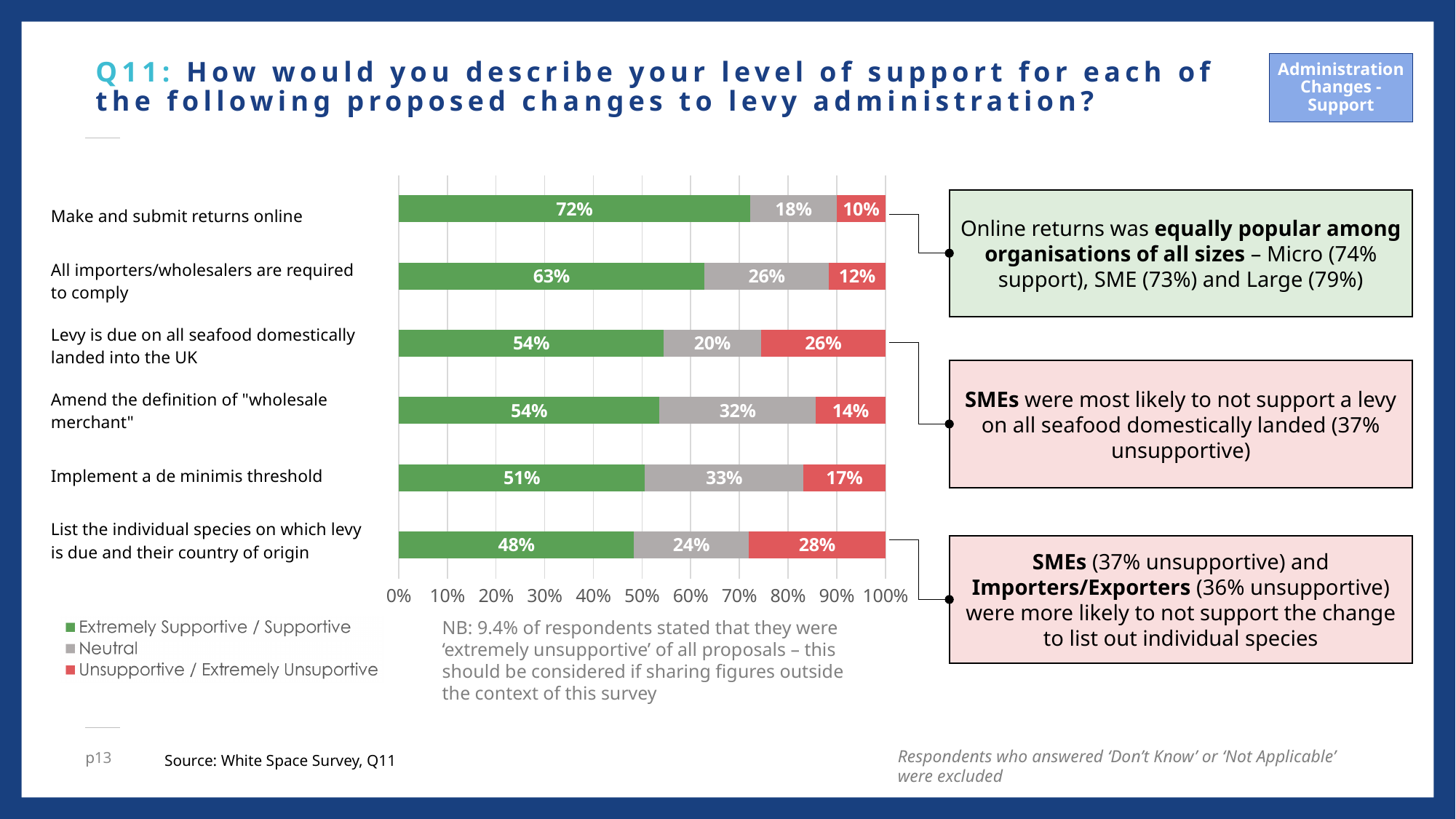
How many series does the legend list? 3 What type of chart is shown on the slide? Stacked bar chart What is the difference in Extremely Supportive / Supportive percentage between 'Make and submit returns online' and 'List the individual species on which levy is due and their country of origin'? 24 percentage points What is the Neutral value for 'Implement a de minimis threshold'? 33% What colour represents the Neutral series in the chart? Grey What is the Unsupportive / Extremely Unsupportive value for 'Levy is due on all seafood domestically landed into the UK'? 26% Which has a higher Extremely Supportive / Supportive percentage: 'Make and submit returns online' or 'All importers/wholesalers are required to comply'? Make and submit returns online How many proposed changes are shown in the chart? 6 Which proposed change has the lowest Extremely Supportive / Supportive percentage? List the individual species on which levy is due and their country of origin Which proposed change has the highest Unsupportive / Extremely Unsupportive percentage? List the individual species on which levy is due and their country of origin What percentage of respondents were Extremely Supportive / Supportive of 'Make and submit returns online'? 72% Which proposed change has the highest Extremely Supportive / Supportive percentage? Make and submit returns online